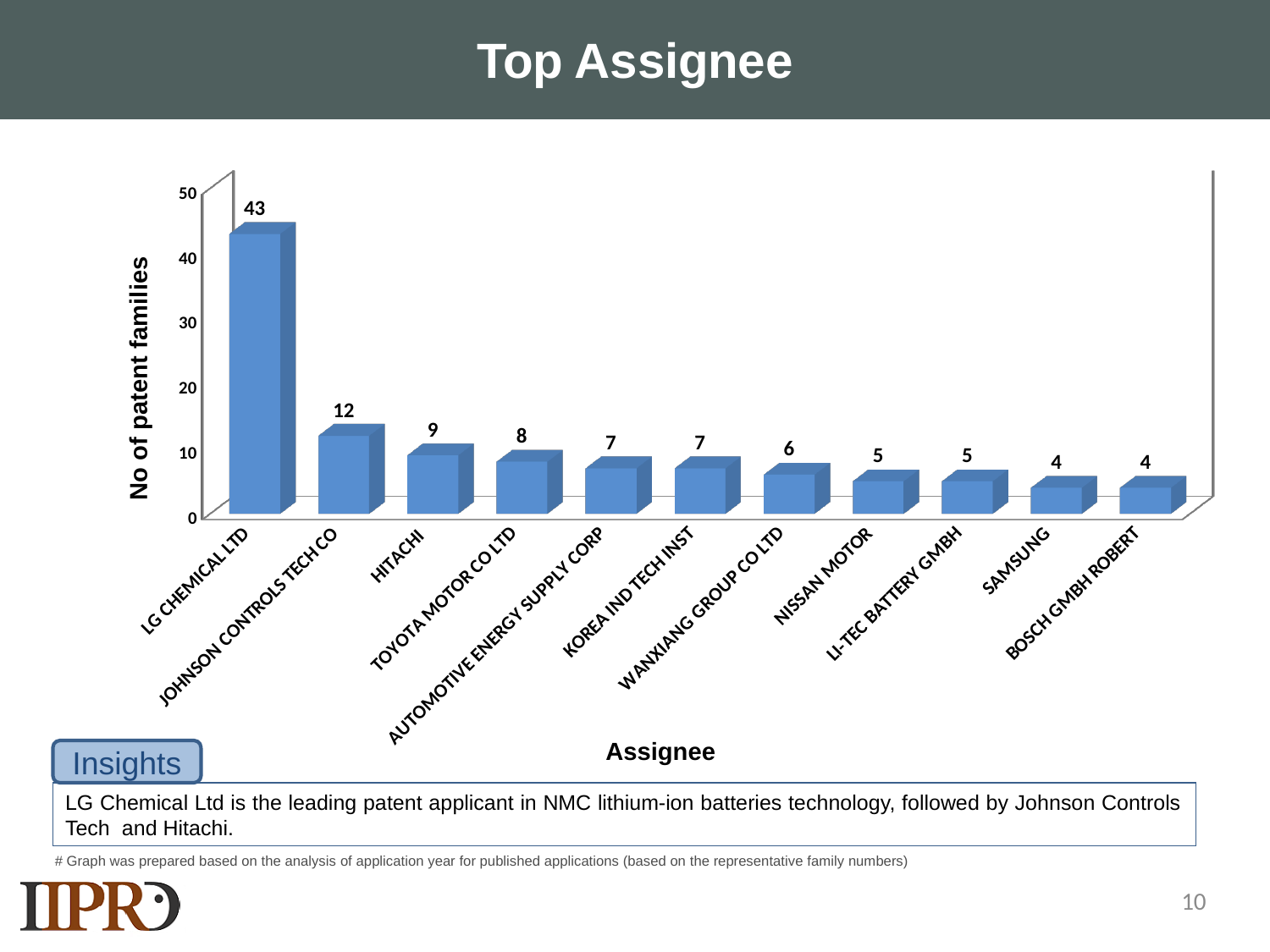
Do the values rise or fall from left to right along the x axis? Fall What is the value for JOHNSON CONTROLS TECH CO? 12 What is the difference between the values for TOYOTA MOTOR CO LTD and NISSAN MOTOR? 3 How many patent families does LG CHEMICAL LTD have? 43 What is the value for HITACHI? 9 What kind of chart is shown on the slide? Bar chart What is the label of the y axis? No of patent families How many assignees are shown on the chart? 11 What is the value for WANXIANG GROUP CO LTD? 6 What is the difference between the values for LG CHEMICAL LTD and JOHNSON CONTROLS TECH CO? 31 Which is larger, the value for HITACHI or the value for SAMSUNG? HITACHI Which assignee has the highest number of patent families? LG CHEMICAL LTD